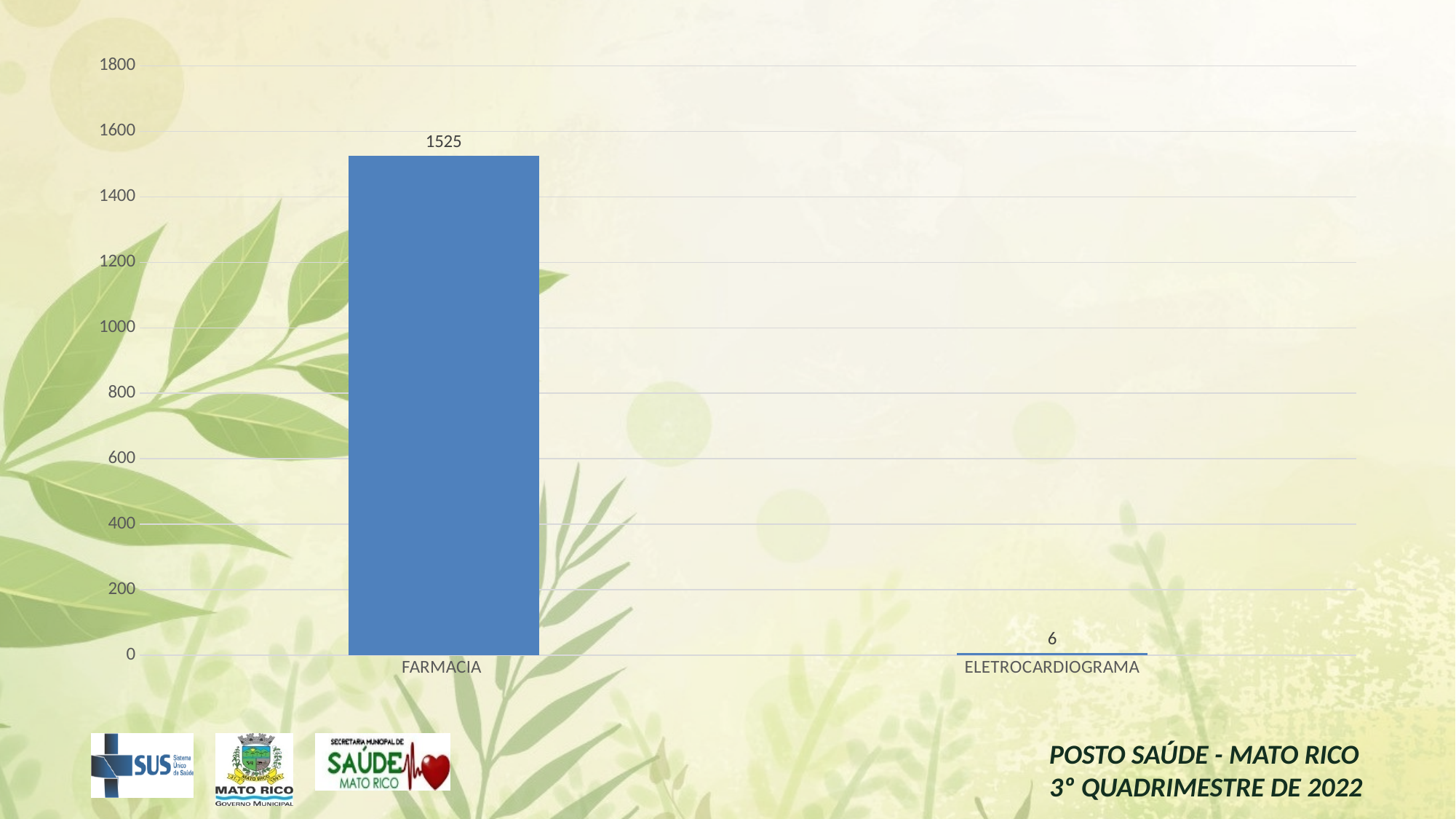
What is the difference between the values for FARMACIA and ELETROCARDIOGRAMA? 1519 What is the highest value shown on the vertical axis? 1800 What is the value for FARMACIA? 1525 What kind of chart is shown on the slide? bar chart What is the value for ELETROCARDIOGRAMA? 6 Is the value for FARMACIA greater or less than 1400? greater Which category has the highest value? FARMACIA What colour are the bars in the chart? blue How many categories are shown on the chart? 2 Which category has the lowest value? ELETROCARDIOGRAMA Is the value for ELETROCARDIOGRAMA greater or less than 200? less Which is larger, the value for FARMACIA or the value for ELETROCARDIOGRAMA? FARMACIA